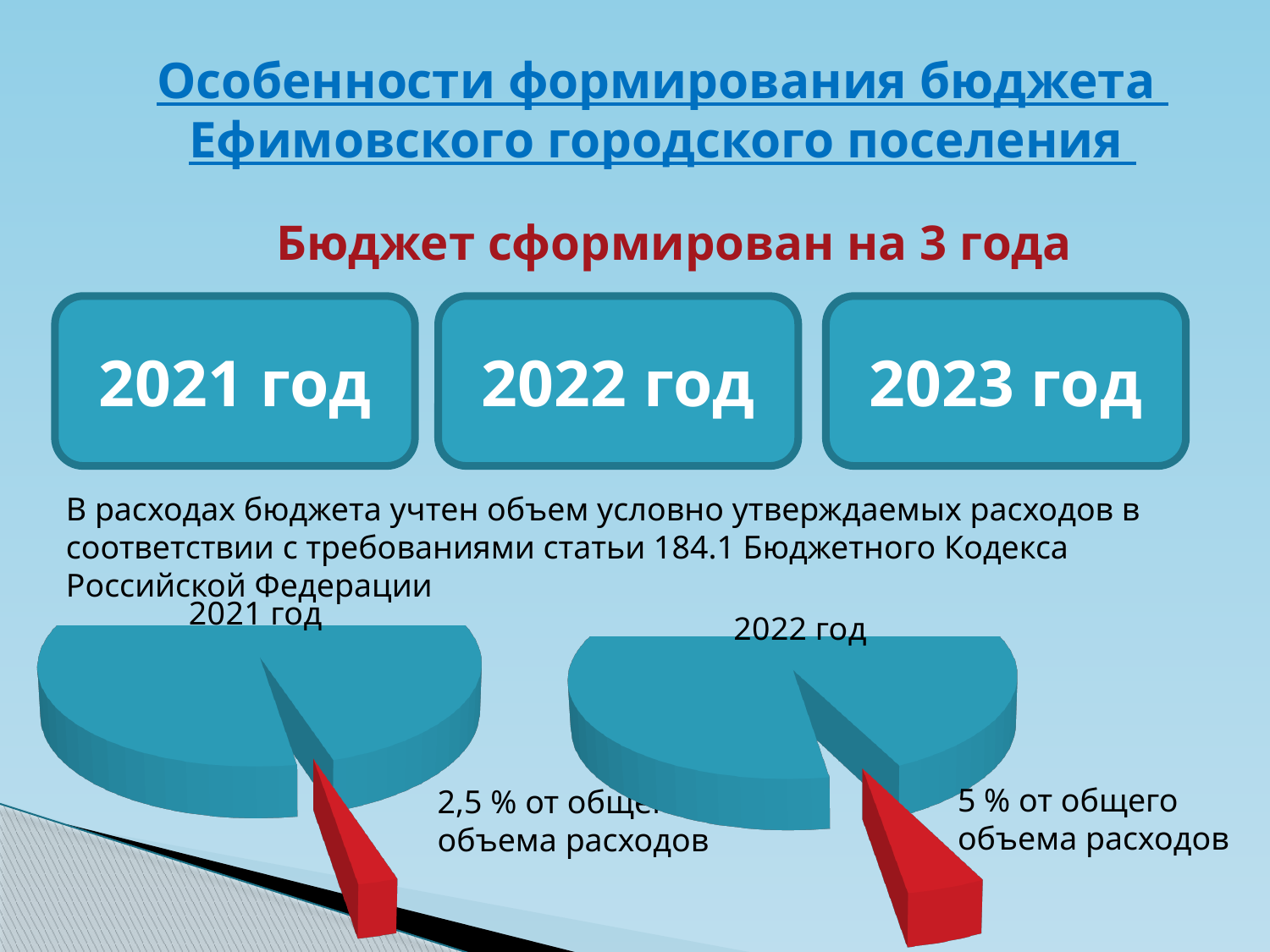
In the 2021 год pie chart, what share of total expenditures does the red exploded slice represent? 2,5 % What kind of chart is shown for 2022 год at the bottom of the slide? pie chart In the 2022 год pie chart, what share of total expenditures does the red exploded slice represent? 5 % Which pie chart has the smaller red slice, 2021 год or 2022 год? 2021 год Does the share of conditionally approved expenditures rise or fall from 2021 год to 2022 год? rise What is the title of the left pie chart on the slide? 2021 год Which pie chart has the larger red slice, 2021 год or 2022 год? 2022 год What colour is the exploded slice in the 2022 год pie chart? red How many pie charts are shown on the slide? 2 How many slices does the 2022 год pie chart have? 2 What kind of chart is shown for 2021 год at the bottom of the slide? pie chart How many slices does the 2021 год pie chart have? 2